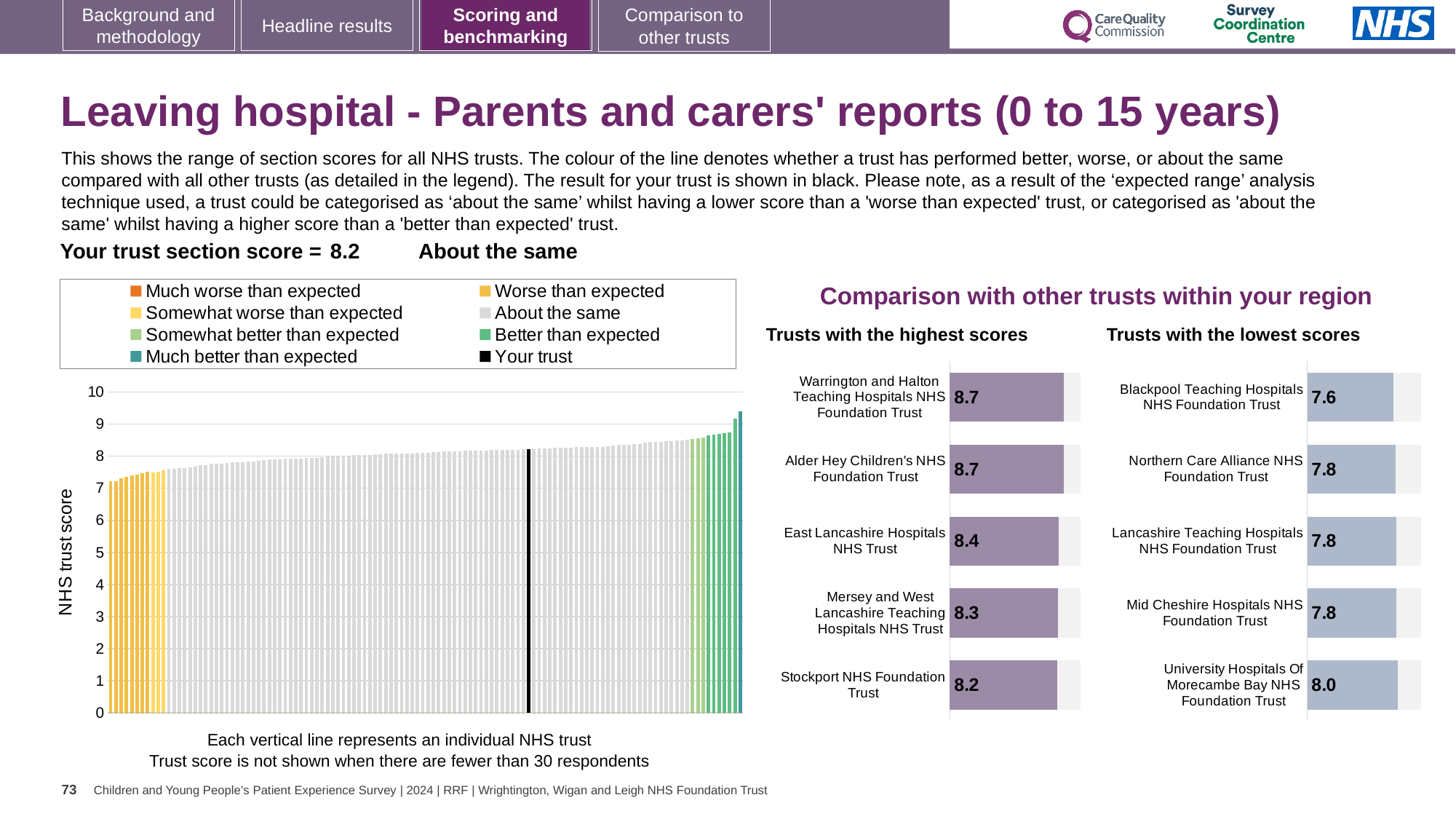
In the 'Trusts with the highest scores' chart, what is the score for Stockport NHS Foundation Trust? 8.2 In the 'Trusts with the highest scores' chart, what is the difference between the score for Warrington and Halton Teaching Hospitals NHS Foundation Trust and the score for Stockport NHS Foundation Trust? 0.5 In the 'Trusts with the highest scores' chart, what is the score for Warrington and Halton Teaching Hospitals NHS Foundation Trust? 8.7 In the large chart on the left showing all NHS trusts, is the value of the lowest bar greater or less than 8? less In the 'Trusts with the lowest scores' chart, what is the score for Blackpool Teaching Hospitals NHS Foundation Trust? 7.6 In the 'Trusts with the lowest scores' chart, which trust has the lowest score? Blackpool Teaching Hospitals NHS Foundation Trust How many trusts are shown in the 'Trusts with the highest scores' chart? 5 In the 'Trusts with the lowest scores' chart, which trust has the highest score? University Hospitals Of Morecambe Bay NHS Foundation Trust Which is larger: the score for East Lancashire Hospitals NHS Trust in the 'Trusts with the highest scores' chart or the score for Mid Cheshire Hospitals NHS Foundation Trust in the 'Trusts with the lowest scores' chart? East Lancashire Hospitals NHS Trust In the large chart on the left showing all NHS trusts, do the bar values rise or fall from left to right? rise How many entries does the legend of the large chart on the left list? 8 What kind of chart is the large chart on the left showing all NHS trusts? bar chart